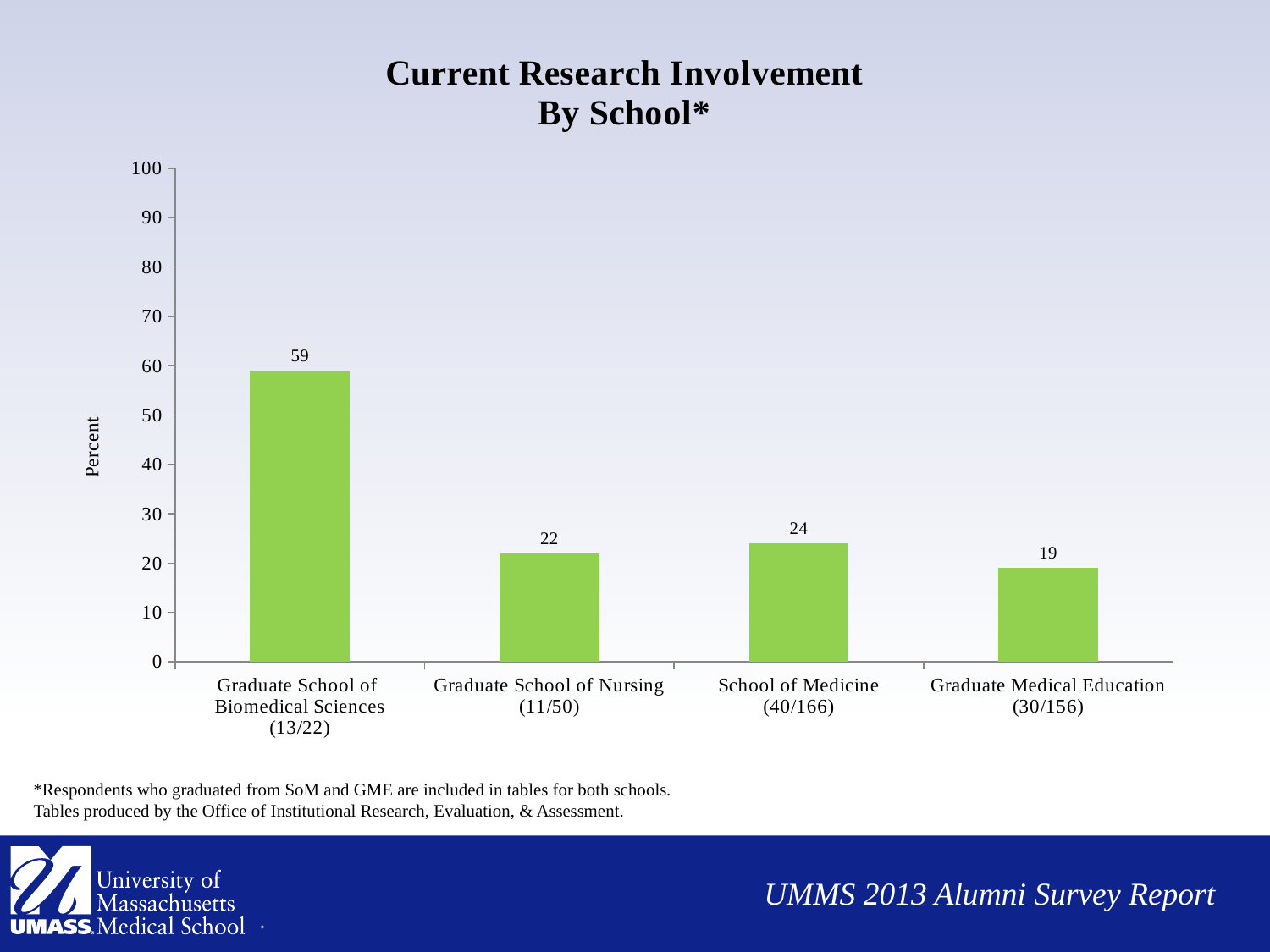
What kind of chart is shown on the slide? Bar chart What is the label of the vertical axis? Percent What is the difference between the values for Graduate School of Biomedical Sciences and School of Medicine? 35 Which school has the lowest value? Graduate Medical Education What is the difference between the values for Graduate School of Nursing and Graduate Medical Education? 3 How many schools are shown on the chart? 4 Which is larger, the value for Graduate School of Biomedical Sciences or the value for Graduate School of Nursing? Graduate School of Biomedical Sciences What is the value for School of Medicine? 24 What is the value for Graduate Medical Education? 19 What is the value for Graduate School of Nursing? 22 Which school has the highest value? Graduate School of Biomedical Sciences What is the value for Graduate School of Biomedical Sciences? 59